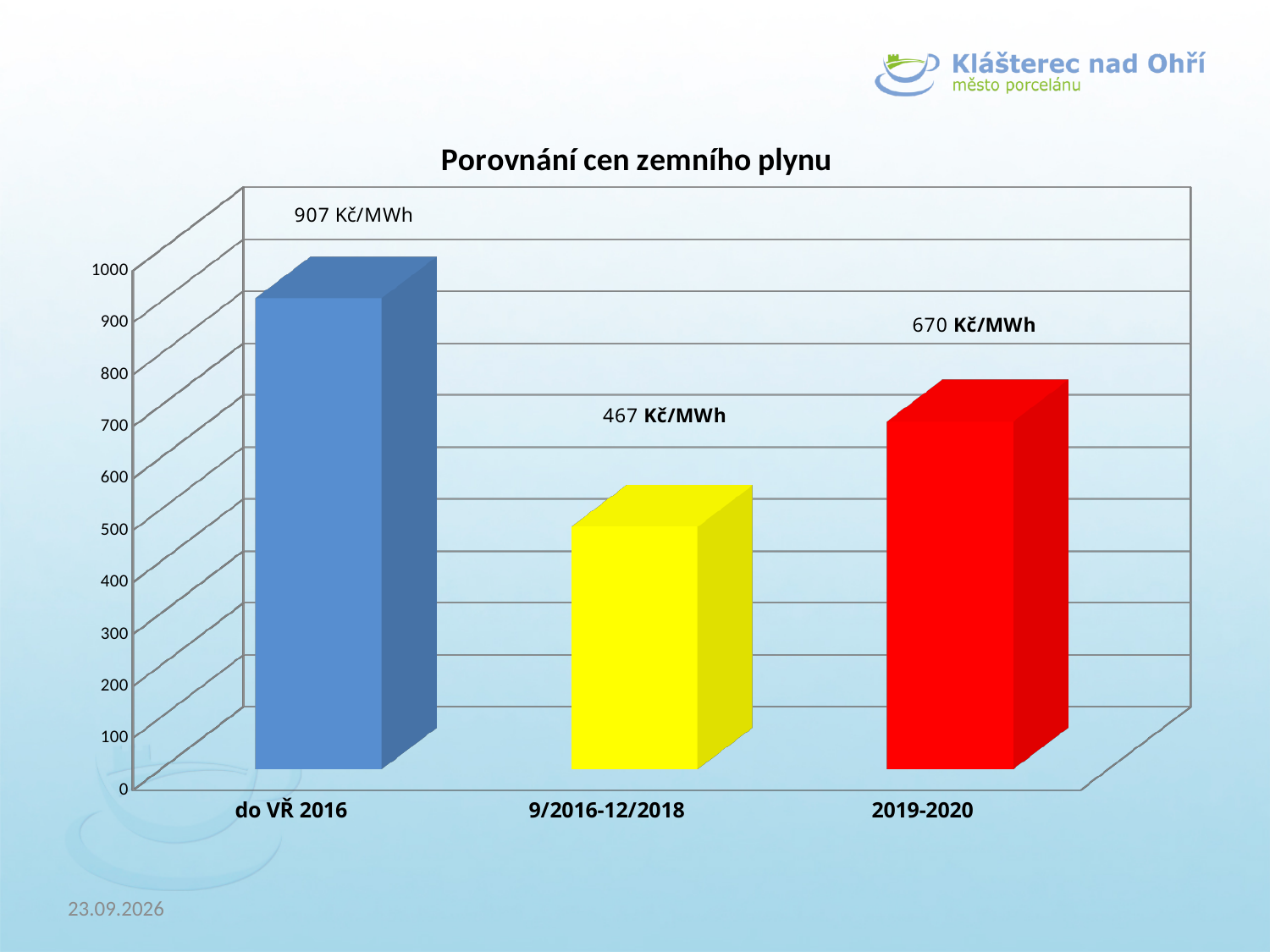
What kind of chart is shown on the slide? bar chart How many categories are shown on the x axis? 3 Is the value for '2019-2020' greater or less than 600? greater What is the value for '2019-2020'? 670 Kč/MWh What is the value for 'do VŘ 2016'? 907 Kč/MWh Which is larger, the value for '2019-2020' or the value for '9/2016-12/2018'? 2019-2020 What is the title of the chart? Porovnání cen zemního plynu What is the difference between the values for 'do VŘ 2016' and '9/2016-12/2018'? 440 Kč/MWh What is the value for '9/2016-12/2018'? 467 Kč/MWh What is the difference between the values for '2019-2020' and '9/2016-12/2018'? 203 Kč/MWh Which category has the lowest value? 9/2016-12/2018 Which category has the highest value? do VŘ 2016